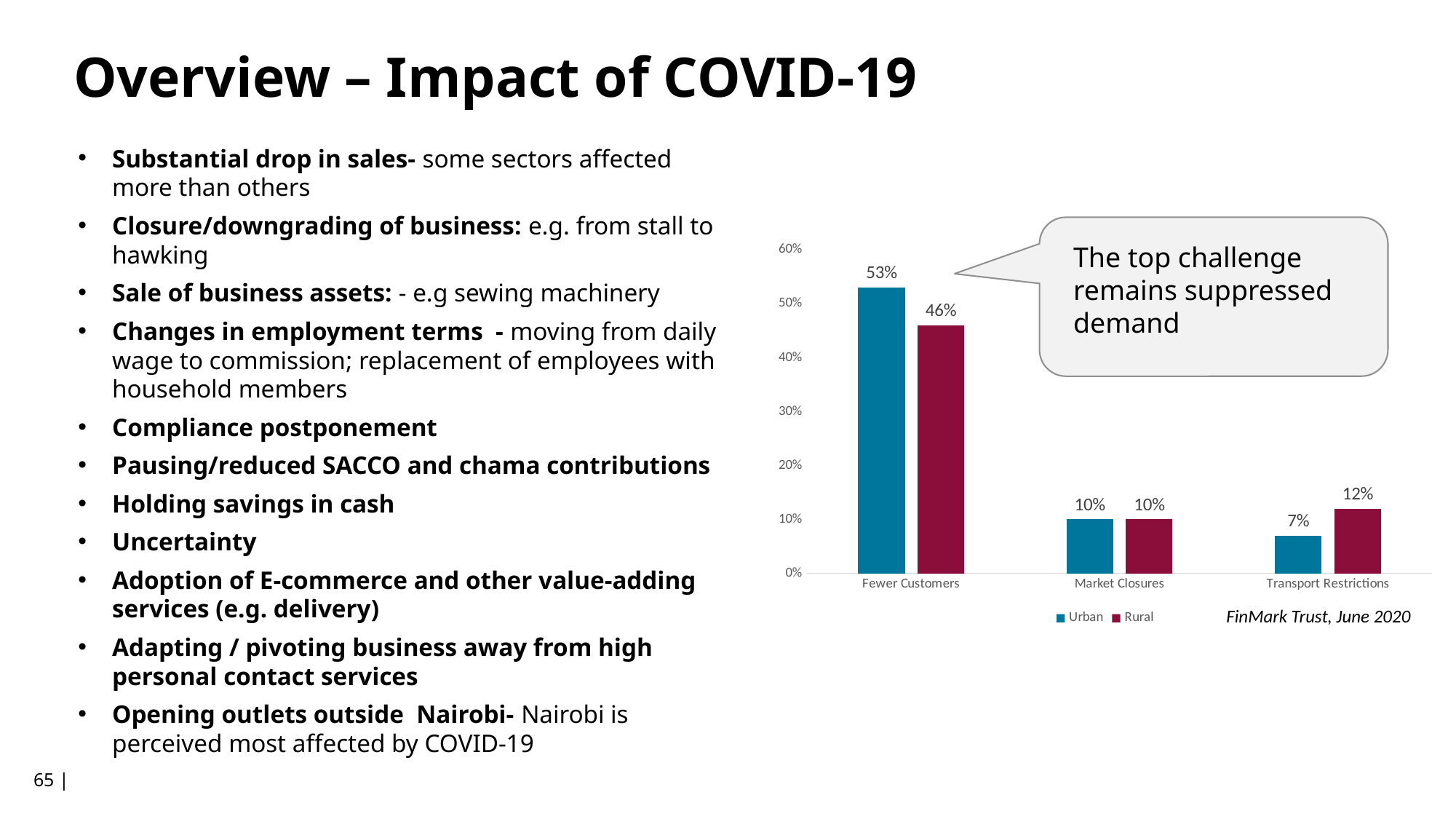
What kind of chart is shown on the slide? Bar chart What is the Rural value for Transport Restrictions? 12% How many series does the legend list? 2 Which category has the highest Urban value? Fewer Customers Which category has the lowest Urban value? Transport Restrictions What is the difference between the Urban and Rural values for Fewer Customers? 7% What is the Urban value for Fewer Customers? 53% For Transport Restrictions, which is larger, the Urban or the Rural value? Rural What is the Rural value for Fewer Customers? 46% What does the callout on the chart say? The top challenge remains suppressed demand What is the Urban value for Transport Restrictions? 7% How many categories are shown on the x axis? 3